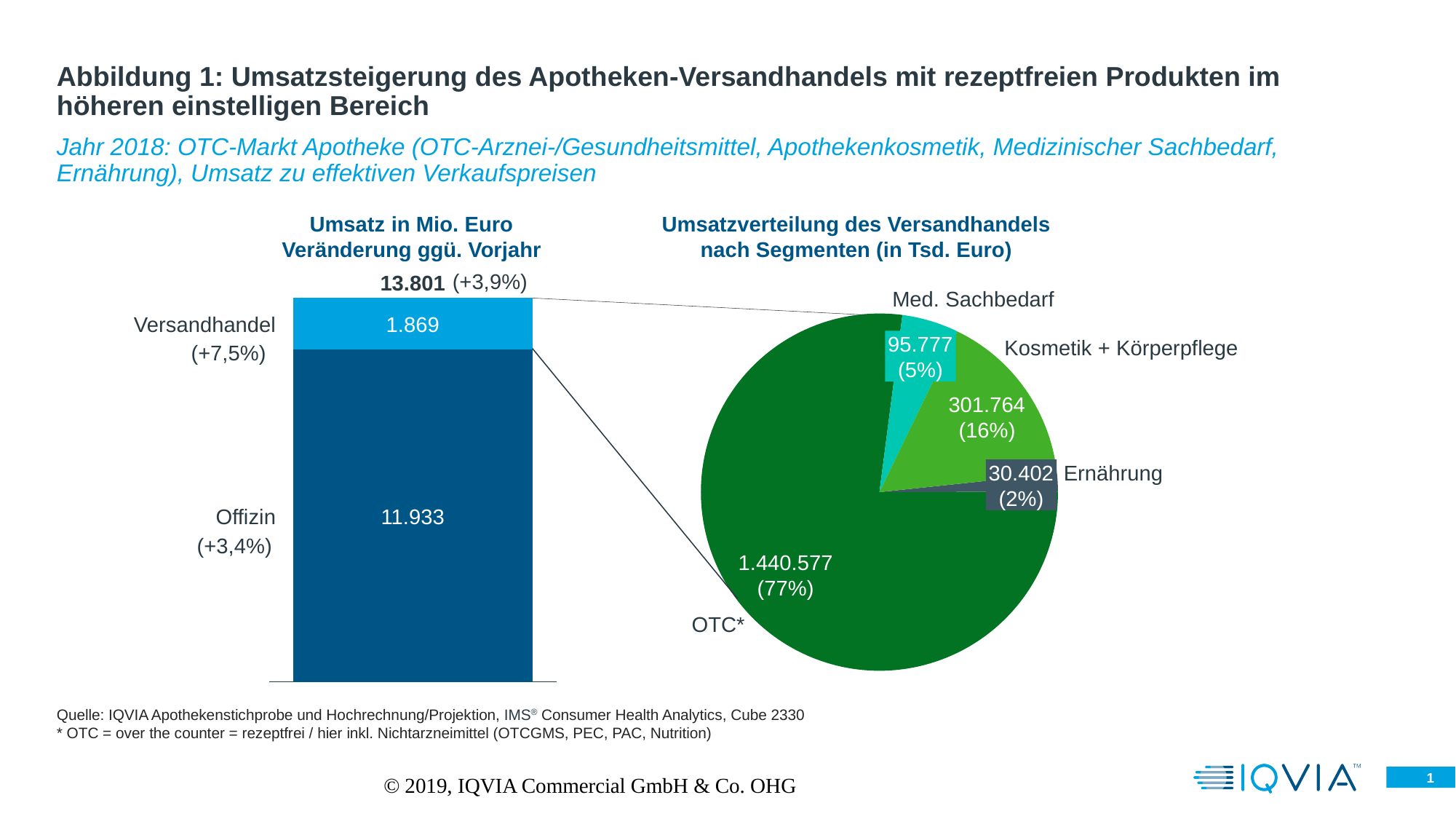
In the pie chart 'Umsatzverteilung des Versandhandels nach Segmenten', how many segments are shown? 4 In the bar chart 'Umsatz in Mio. Euro', what is the value for Offizin? 11.933 In the pie chart 'Umsatzverteilung des Versandhandels nach Segmenten', what is the value for Med. Sachbedarf? 95.777 In the pie chart 'Umsatzverteilung des Versandhandels nach Segmenten', what is the value for Kosmetik + Körperpflege? 301.764 What kind of chart is the left chart 'Umsatz in Mio. Euro'? Stacked bar chart In the bar chart 'Umsatz in Mio. Euro', what is the total of the stacked bar? 13.801 In the bar chart 'Umsatz in Mio. Euro', what is the value for Versandhandel? 1.869 In the bar chart 'Umsatz in Mio. Euro', what is the difference between the Offizin and Versandhandel values? 10.064 In the bar chart 'Umsatz in Mio. Euro', what percentage change versus the prior year is shown for Versandhandel? +7,5% In the pie chart 'Umsatzverteilung des Versandhandels nach Segmenten', what share does OTC* have? 77% In the pie chart 'Umsatzverteilung des Versandhandels nach Segmenten', which segment is the smallest? Ernährung In the bar chart 'Umsatz in Mio. Euro', which segment is larger, Offizin or Versandhandel? Offizin